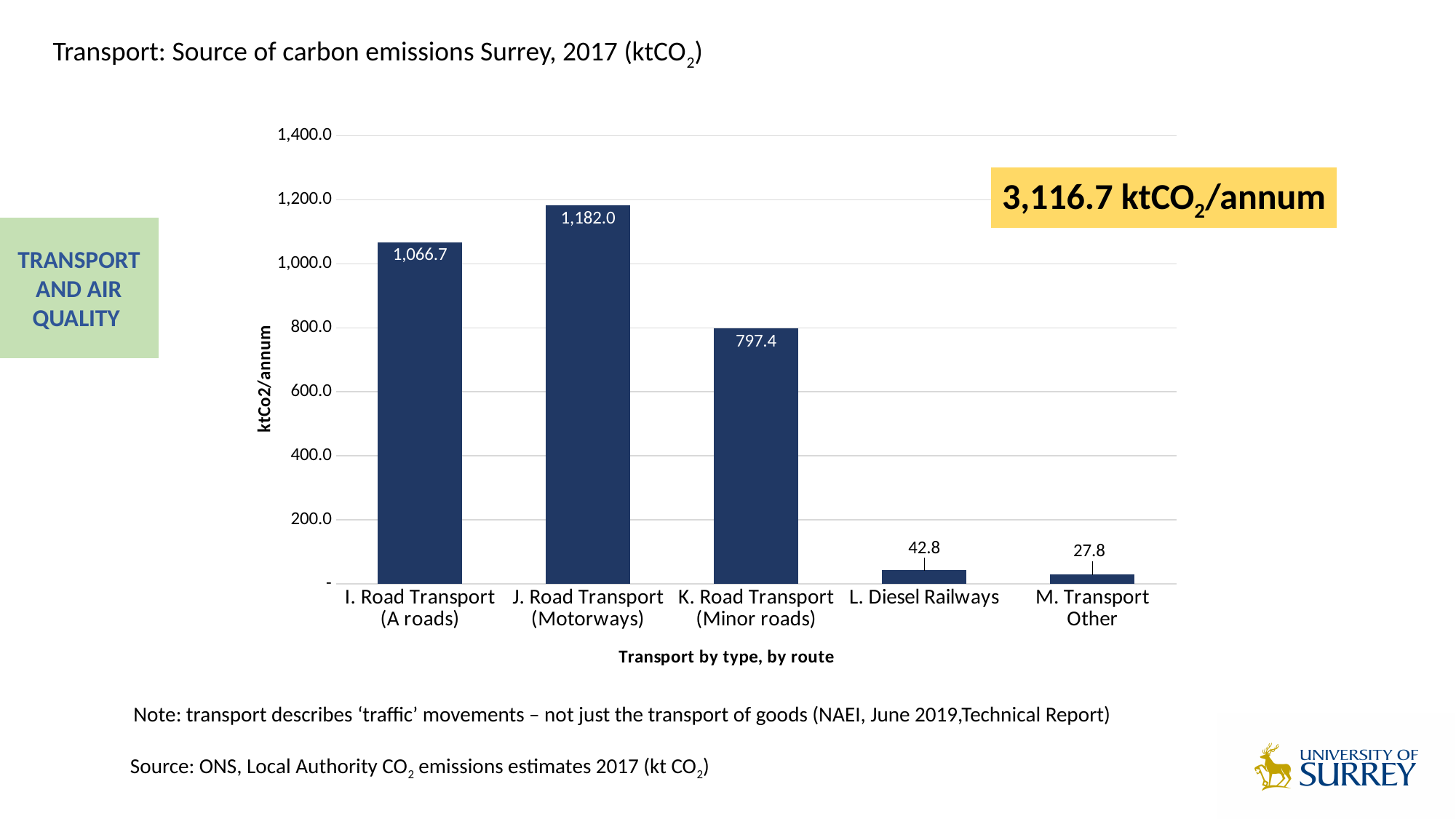
What is the value for J. Road Transport (Motorways)? 1,182.0 What kind of chart is shown? bar chart Which is larger, I. Road Transport (A roads) or K. Road Transport (Minor roads)? I. Road Transport (A roads) What total figure is shown in the yellow box on the slide? 3,116.7 ktCO2/annum Is the value for K. Road Transport (Minor roads) greater or less than 1,000.0? less How many categories are shown on the x axis? 5 What is the value for I. Road Transport (A roads)? 1,066.7 Which category has the lowest value? M. Transport Other What is the value for L. Diesel Railways? 42.8 Which category has the highest value? J. Road Transport (Motorways) What is the label of the y axis? ktCo2/annum What is the difference between J. Road Transport (Motorways) and K. Road Transport (Minor roads)? 384.6